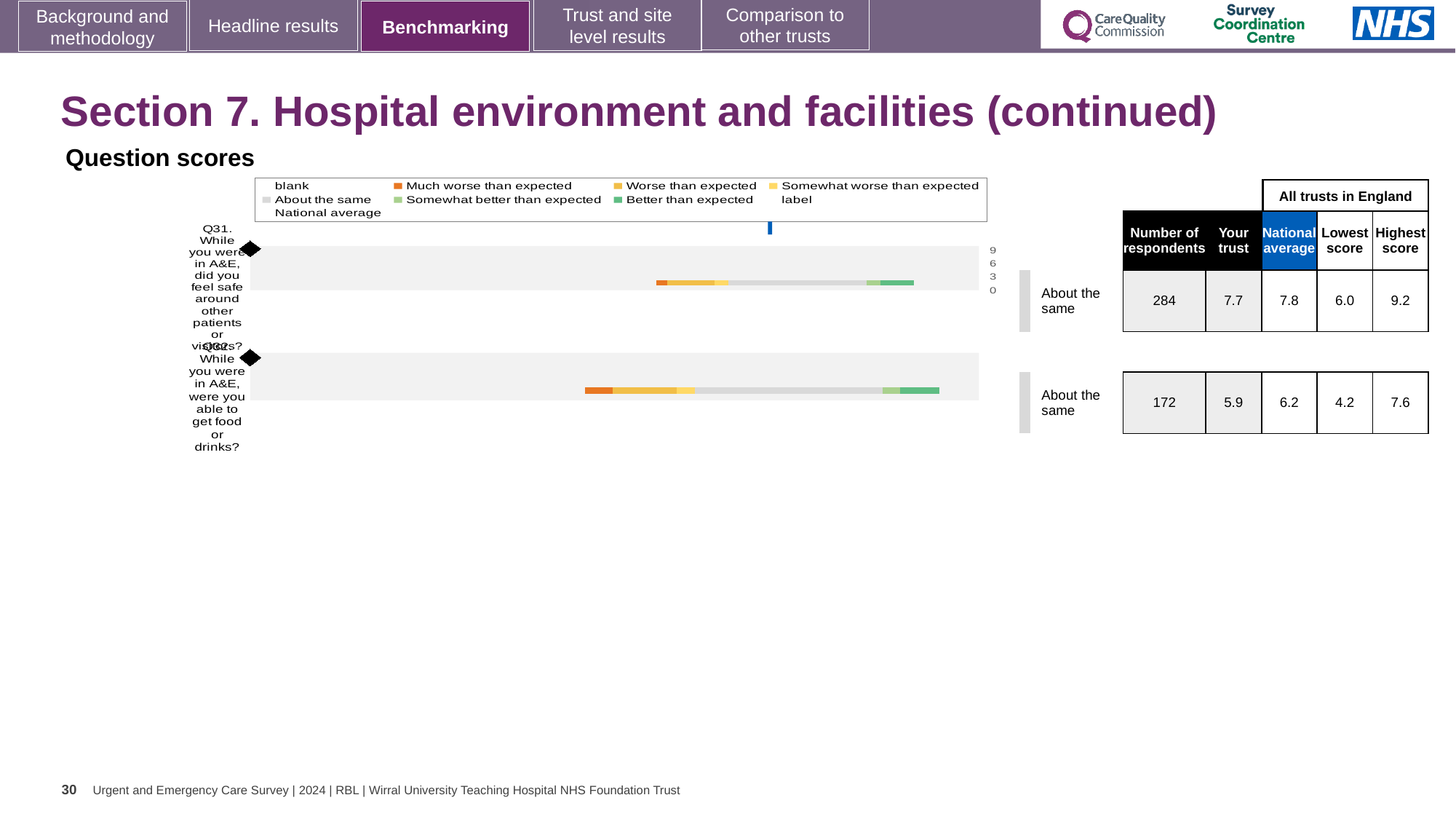
What is the 'Your trust' score for Q32 (being able to get food or drinks in A&E)? 5.9 What is the national average score for Q31? 7.8 Which is larger for Q31: the 'Your trust' score or the national average? National average What is the highest score among all trusts in England for Q32? 7.6 What is the difference between the highest and lowest scores for Q32? 3.4 Which question has the higher 'Your trust' score, Q31 or Q32? Q31 What kind of chart is used to show the question scores on this slide? bar chart What is the lowest score among all trusts in England for Q31? 6.0 What benchmark category is shown for Q32 next to the chart? About the same What is the number of respondents for Q31 (feeling safe around other patients or visitors in A&E)? 284 How many more respondents answered Q31 than Q32? 112 How many questions are plotted in the question scores chart? 2